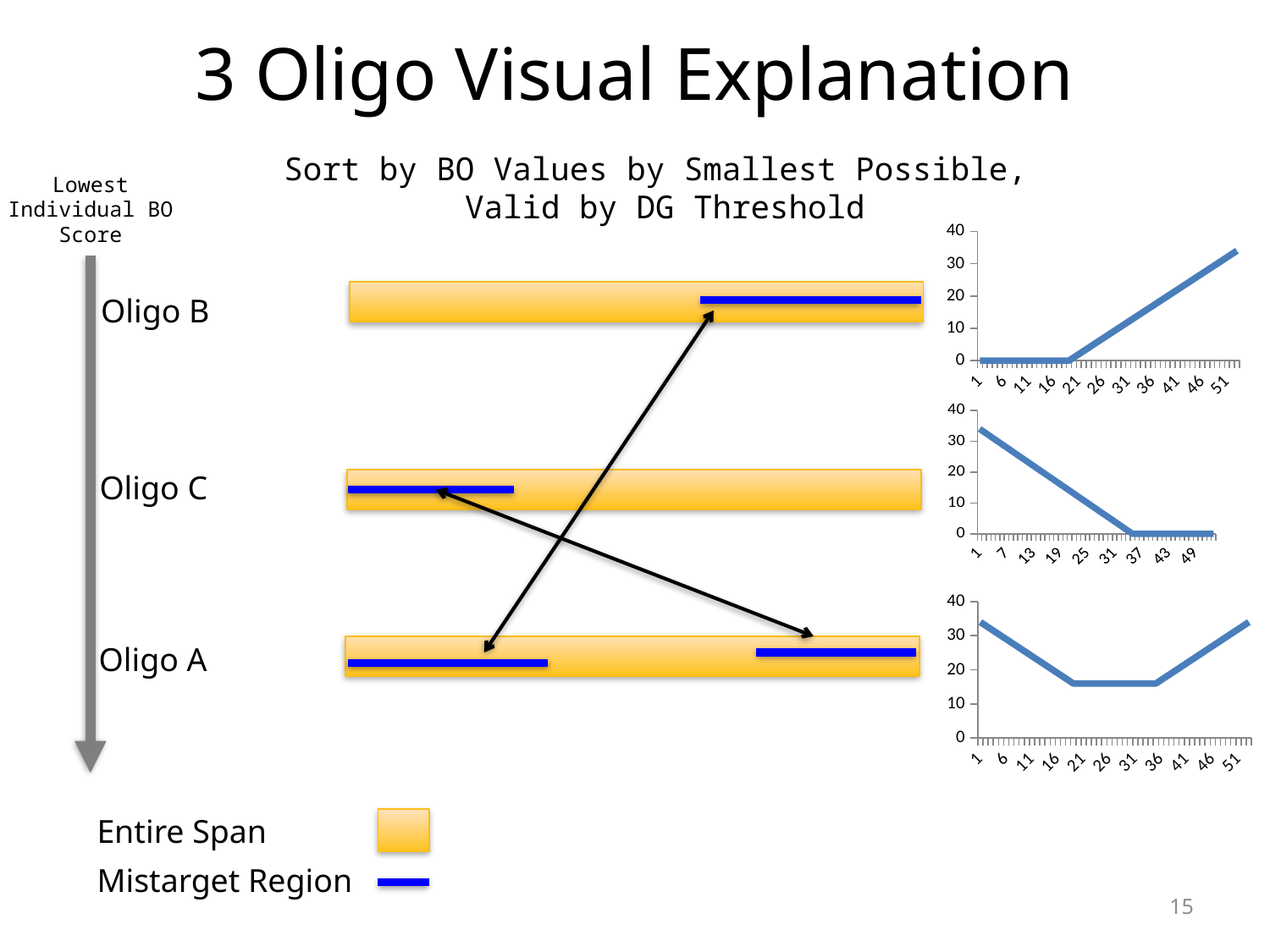
In the top-right chart, do the values rise or fall as the x axis moves from 21 to 51? rise In the top-right chart, is the value at x = 11 greater or less than 10? less In the middle-right chart, is the value at x = 1 greater or less than 30? greater What kind of chart is the top chart on the right side of the slide? line chart In the top-right chart, is the value at x = 51 greater or less than 30? greater What is the highest value shown on the y axis of the top-right chart? 40 In the middle-right chart, do the values rise or fall as the x axis moves from 1 to 37? fall How many small charts are shown on the right side of the slide? 3 In the bottom-right chart, which is larger: the value at x = 1 or the value at x = 26? x = 1